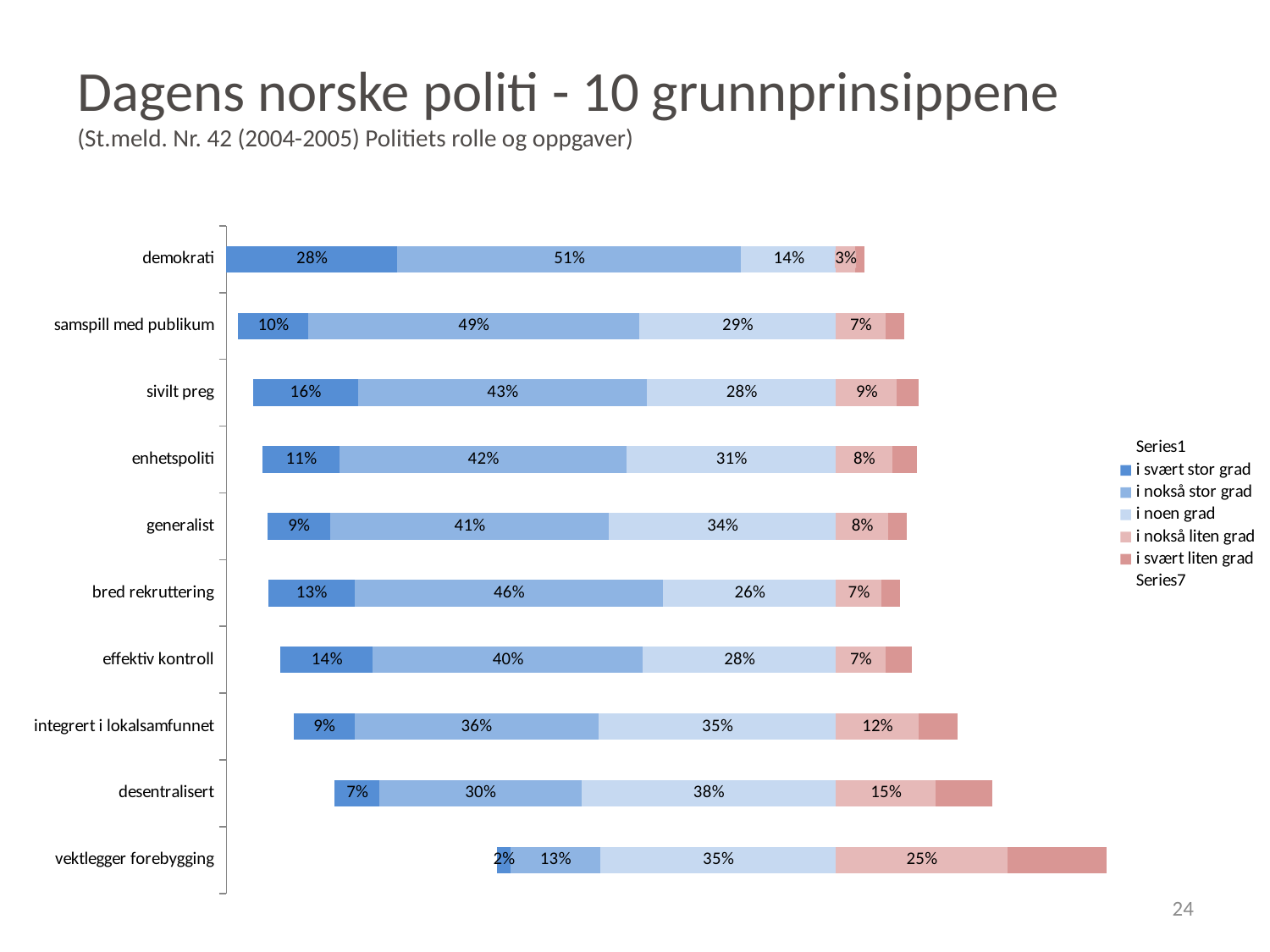
Which category has the highest value for 'i svært stor grad'? demokrati In the demokrati bar, what is the difference between the 'i nokså stor grad' value and the 'i svært stor grad' value? 23 percentage points What is the value for 'i nokså stor grad' in the 'samspill med publikum' bar? 49% How many categories are shown on the vertical axis of the chart? 10 Which has the larger 'i nokså stor grad' value: sivilt preg or effektiv kontroll? sivilt preg What kind of chart is shown on the slide? Stacked bar chart What is the title of the slide? Dagens norske politi - 10 grunnprinsippene Which category has the lowest value for 'i nokså stor grad'? vektlegger forebygging What is the value for 'i noen grad' in the desentralisert bar? 38% What is the value for 'i svært stor grad' in the demokrati bar? 28% How many entries does the legend list? 7 What is the value for 'i nokså liten grad' in the 'vektlegger forebygging' bar? 25%